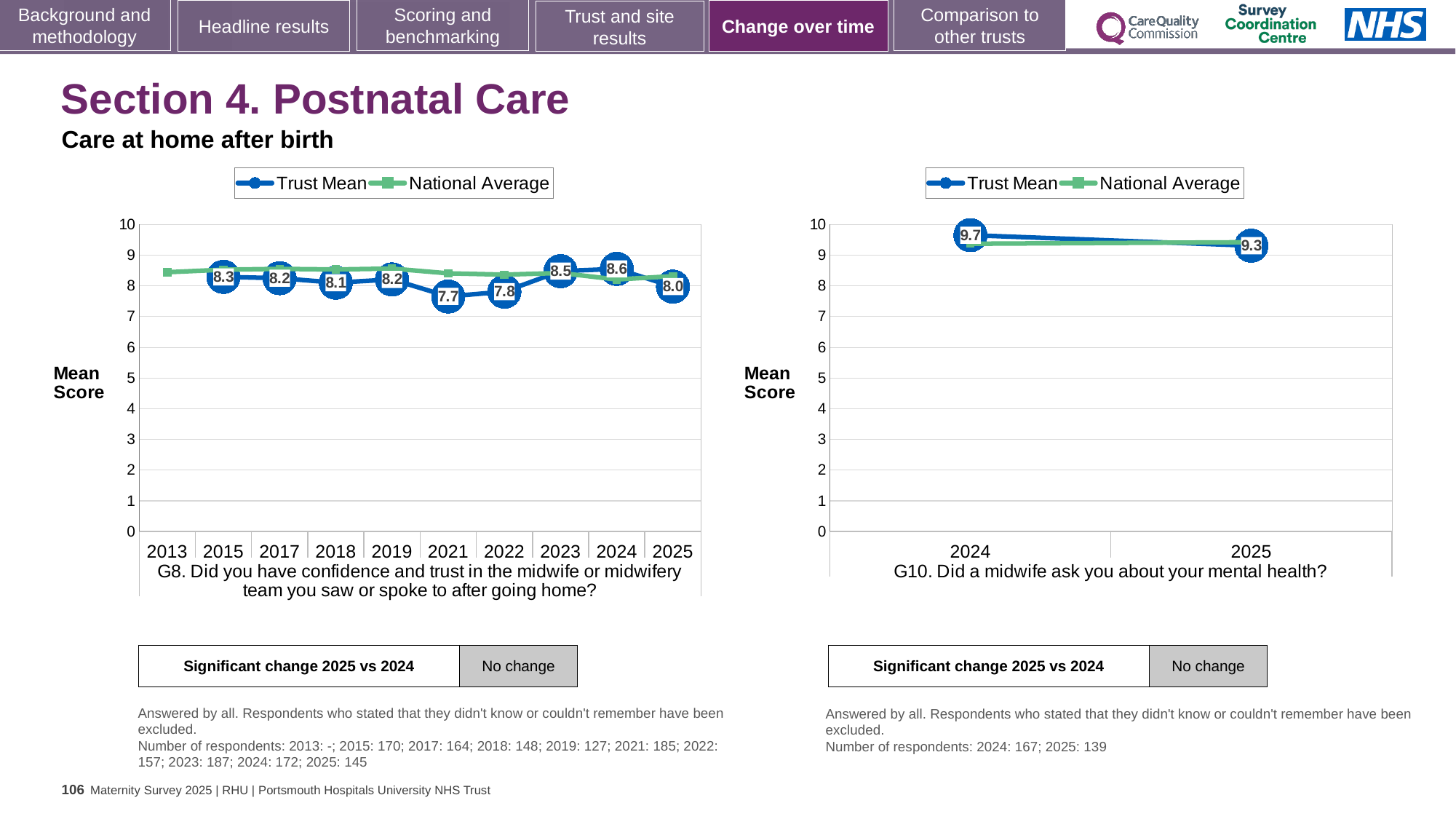
How many years are shown on the x axis of the left chart (G8)? 10 In the left chart (G8), what is the Trust Mean score for 2024? 8.6 In the left chart (G8), which year has the larger Trust Mean score, 2023 or 2025? 2023 In the left chart (G8), is the National Average value for 2013 greater or less than 8? greater In the left chart (G8), what is the Trust Mean score for 2021? 7.7 How many series does the legend of the left chart (G8) list? 2 In the left chart (G8), which year has the lowest Trust Mean score? 2021 In the right chart (G10), what is the Trust Mean score for 2025? 9.3 In the right chart (G10), does the Trust Mean score rise or fall from 2024 to 2025? fall In the left chart (G8), what is the difference between the Trust Mean scores for 2024 and 2025? 0.6 What kind of chart is the left chart (G8)? line chart In the left chart (G8), which year has the highest Trust Mean score? 2024